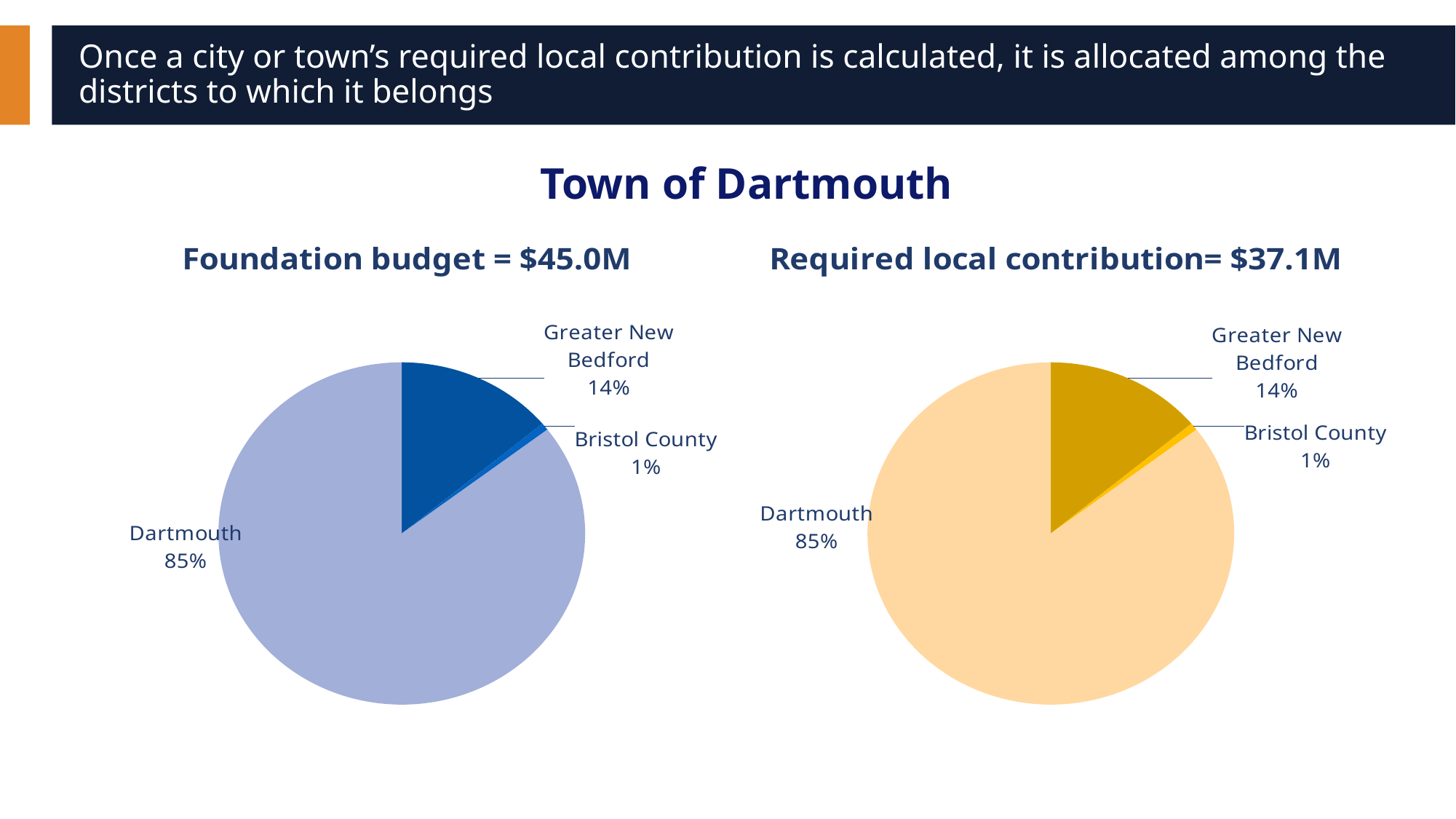
In the 'Required local contribution= $37.1M' pie chart, which is larger, Greater New Bedford or Bristol County? Greater New Bedford What is the title of the left chart? Foundation budget = $45.0M In the 'Foundation budget = $45.0M' pie chart, what share does Dartmouth have? 85% What town do the two pie charts on the slide describe? Town of Dartmouth In the 'Required local contribution= $37.1M' pie chart, what share does Dartmouth have? 85% In the 'Foundation budget = $45.0M' pie chart, what is the difference in percentage points between Dartmouth and Greater New Bedford? 71 What type of chart is used for the 'Required local contribution= $37.1M' chart? Pie chart How many slices does the 'Foundation budget = $45.0M' pie chart have? 3 In the 'Required local contribution= $37.1M' pie chart, which slice is the smallest? Bristol County In the 'Foundation budget = $45.0M' pie chart, what share does Greater New Bedford have? 14% In the 'Foundation budget = $45.0M' pie chart, which slice is the largest? Dartmouth